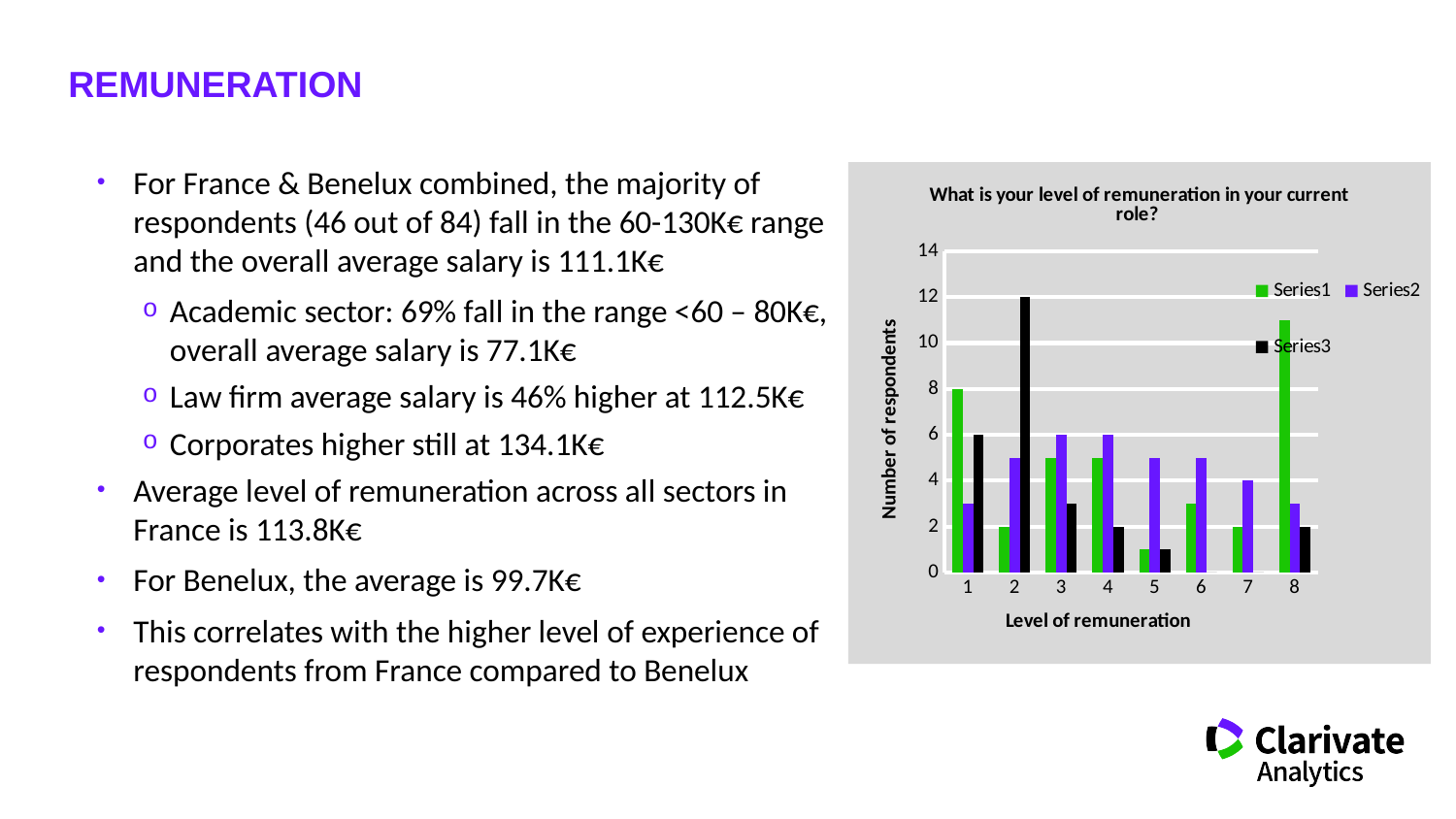
What is the number of respondents for Series3 at level 2? 12 Is the value for Series1 at level 8 greater or less than 10? greater At which level of remuneration is the Series1 value highest? 8 How many levels of remuneration are shown on the x axis? 8 At which level of remuneration is the Series3 value highest? 2 What kind of chart is shown on the slide? bar chart What is the title of the chart? What is your level of remuneration in your current role? Which is larger at level 2: Series1 or Series3? Series3 What is the number of respondents for Series2 at level 7? 4 What is the number of respondents for Series2 at level 3? 6 How many series does the chart legend list? 3 What is the number of respondents for Series1 at level 1? 8